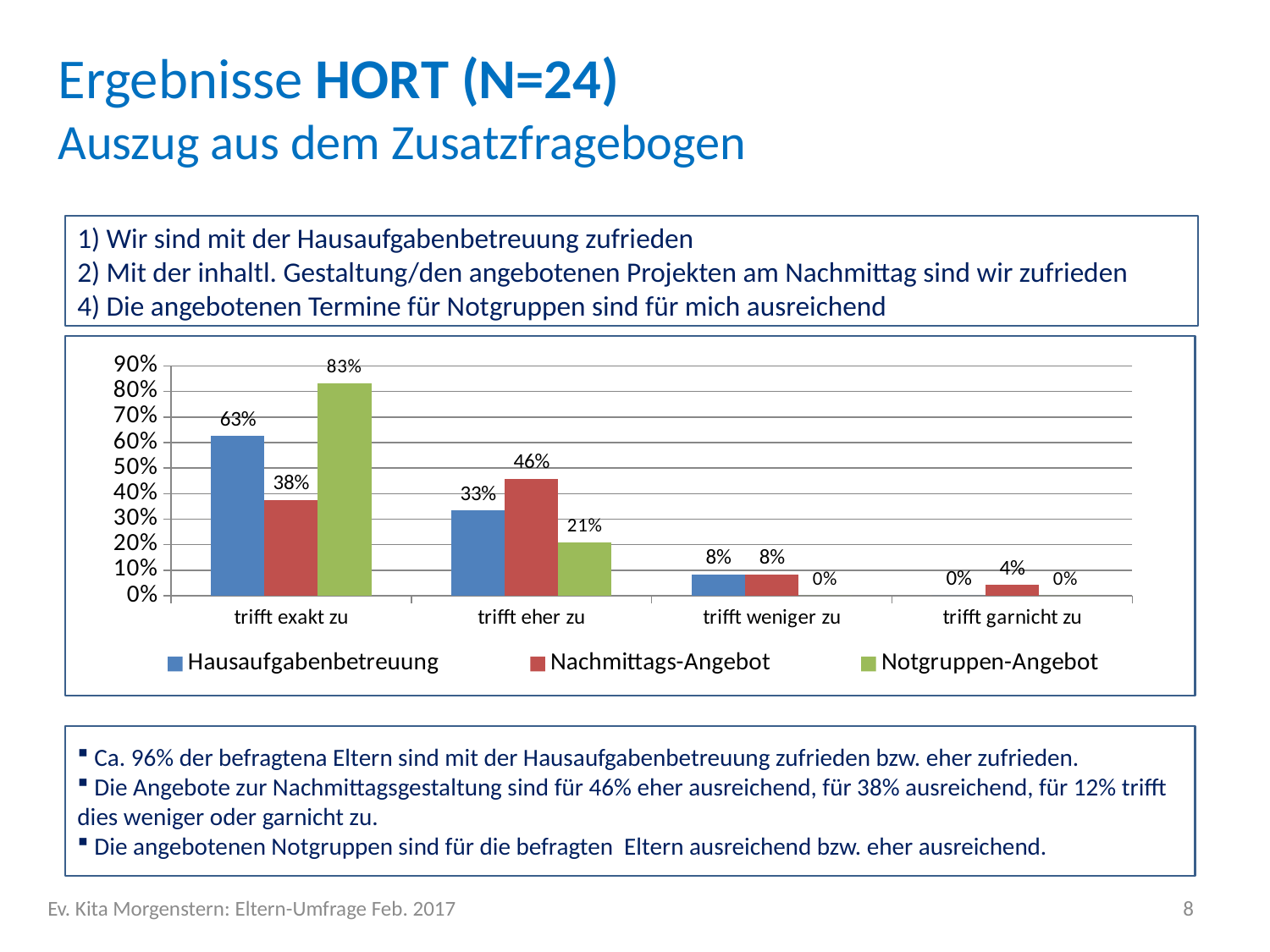
How many categories are shown on the x axis? 4 Which series has the lowest value in the 'trifft eher zu' category? Notgruppen-Angebot What kind of chart is shown on the slide? Bar chart What is the value for Hausaufgabenbetreuung in the 'trifft exakt zu' category? 63% What is the difference between the Notgruppen-Angebot and Hausaufgabenbetreuung values in the 'trifft exakt zu' category? 20% Do the values for Notgruppen-Angebot rise or fall from 'trifft exakt zu' to 'trifft weniger zu'? Fall Which series has the highest value in the 'trifft exakt zu' category? Notgruppen-Angebot How many series does the legend list? 3 What is the value for Nachmittags-Angebot in the 'trifft garnicht zu' category? 4% What is the value for Nachmittags-Angebot in the 'trifft eher zu' category? 46% Which is larger in the 'trifft eher zu' category: Hausaufgabenbetreuung or Nachmittags-Angebot? Nachmittags-Angebot What is the value for Notgruppen-Angebot in the 'trifft exakt zu' category? 83%